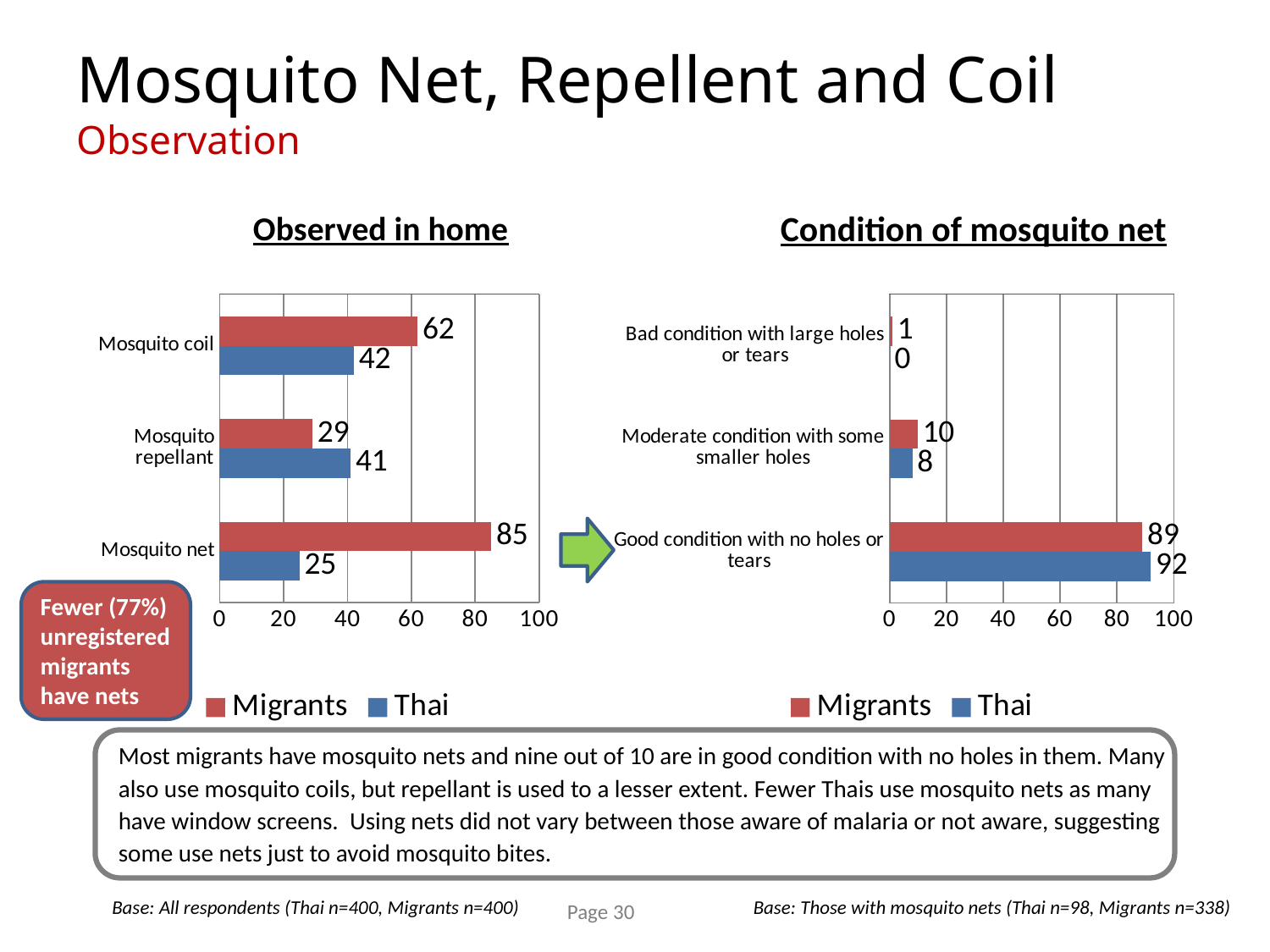
In the 'Observed in home' chart, what is the difference between the Migrants and Thai values for Mosquito net? 60 In the 'Observed in home' chart, which is larger for Mosquito repellant: Migrants or Thai? Thai What type of chart is the 'Observed in home' chart? Bar chart In the 'Observed in home' chart, what is the value for Migrants for Mosquito net? 85 In the 'Condition of mosquito net' chart, what is the difference between the Migrants and Thai values for 'Moderate condition with some smaller holes'? 2 In the 'Observed in home' chart, how many categories are shown? 3 In the 'Observed in home' chart, what is the value for Thai for Mosquito coil? 42 In the 'Condition of mosquito net' chart, what is the Migrants value for 'Moderate condition with some smaller holes'? 10 How many series does the legend of the 'Condition of mosquito net' chart list? 2 In the 'Condition of mosquito net' chart, what is the Thai value for 'Good condition with no holes or tears'? 92 In the 'Condition of mosquito net' chart, which category has the highest Migrants value? Good condition with no holes or tears In the 'Observed in home' chart, which category has the lowest Thai value? Mosquito net